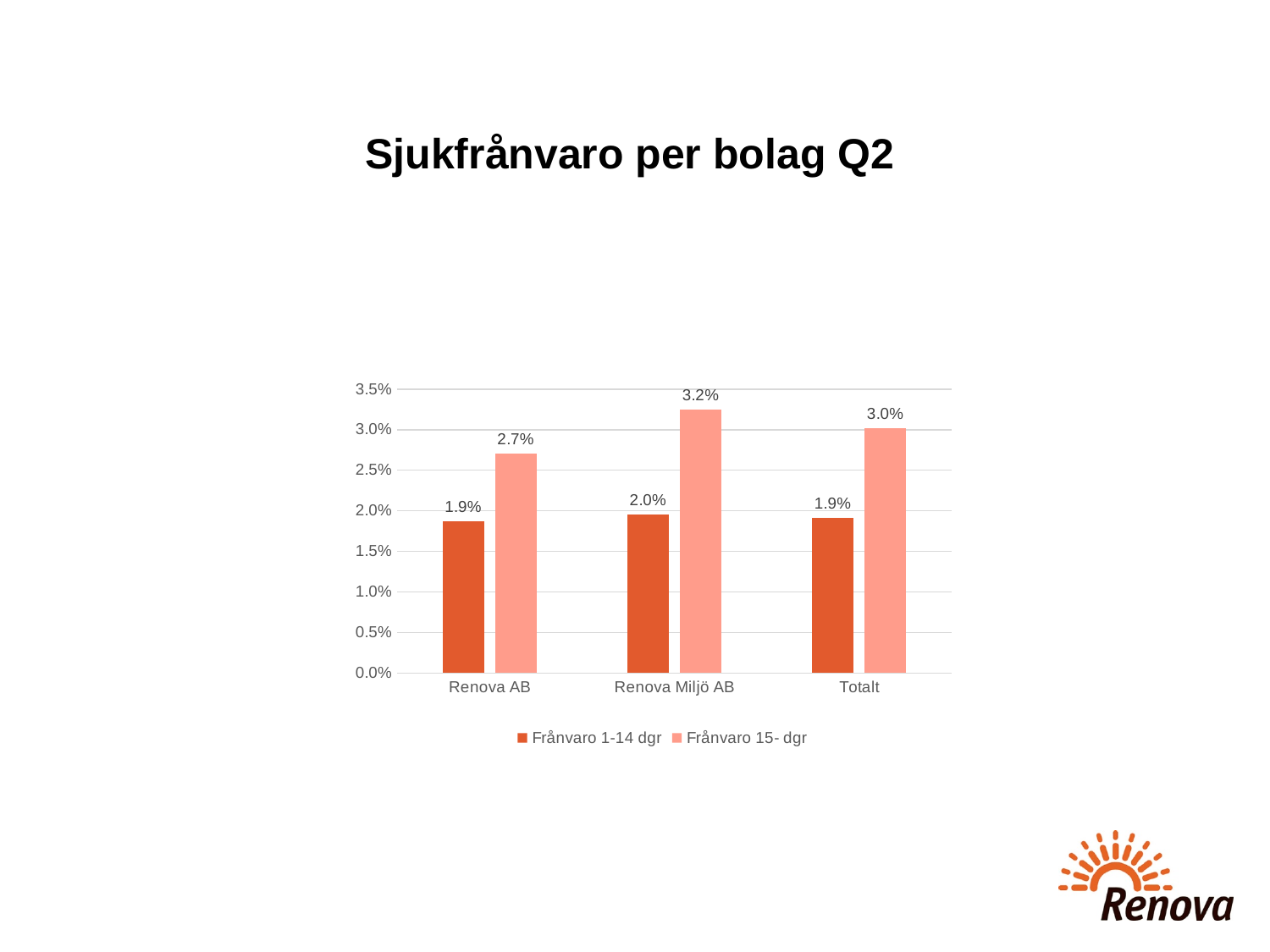
What type of chart is shown on the slide? Bar chart What is the value for Frånvaro 1-14 dgr for Renova AB? 1.9% Which category has the highest value for Frånvaro 15- dgr? Renova Miljö AB What is the value for Frånvaro 1-14 dgr for Renova Miljö AB? 2.0% For Totalt, which is larger: Frånvaro 1-14 dgr or Frånvaro 15- dgr? Frånvaro 15- dgr Is the Frånvaro 15- dgr value for Renova AB greater or less than 2.5%? greater How many series does the legend list? 2 What is the value for Frånvaro 15- dgr for Totalt? 3.0% Which category has the lowest value for Frånvaro 15- dgr? Renova AB What is the difference between the Frånvaro 15- dgr values for Renova Miljö AB and Renova AB? 0.5% What is the value for Frånvaro 15- dgr for Renova Miljö AB? 3.2% How many categories are shown on the x axis? 3